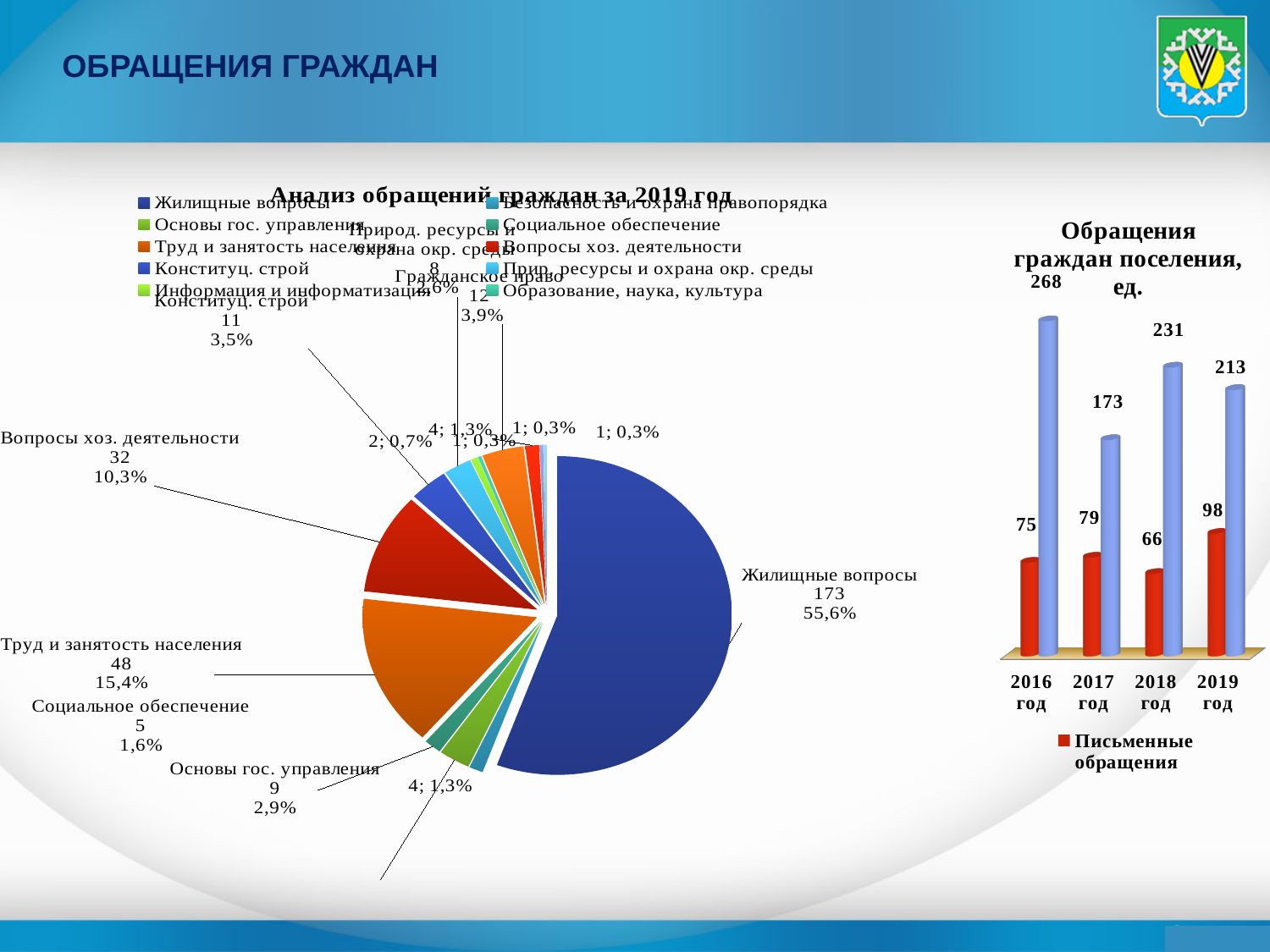
In the bar chart 'Обращения граждан поселения, ед.', which year has the highest value for the blue bars? 2016 год In the pie chart 'Анализ обращений граждан за 2019 год', what is the value for 'Вопросы хоз. деятельности'? 32 In the pie chart 'Анализ обращений граждан за 2019 год', what share of appeals is 'Жилищные вопросы'? 55,6% In the bar chart 'Обращения граждан поселения, ед.', what is the value of the tall blue bar for 2016 год? 268 In the bar chart 'Обращения граждан поселения, ед.', which year has the lowest value for 'Письменные обращения'? 2018 год In the pie chart 'Анализ обращений граждан за 2019 год', what percentage is shown for 'Социальное обеспечение'? 1,6% In the pie chart 'Анализ обращений граждан за 2019 год', how many appeals are labelled for 'Труд и занятость населения'? 48 In the bar chart 'Обращения граждан поселения, ед.', how many 'Письменные обращения' are shown for 2019 год? 98 In the pie chart 'Анализ обращений граждан за 2019 год', which category has the largest slice? Жилищные вопросы In the bar chart 'Обращения граждан поселения, ед.', what is the difference between the blue bar values for 2018 год and 2019 год? 18 In the pie chart 'Анализ обращений граждан за 2019 год', what is the difference between the values for 'Жилищные вопросы' and 'Труд и занятость населения'? 125 What type of chart is the chart on the right of the slide, 'Обращения граждан поселения, ед.'? Bar chart